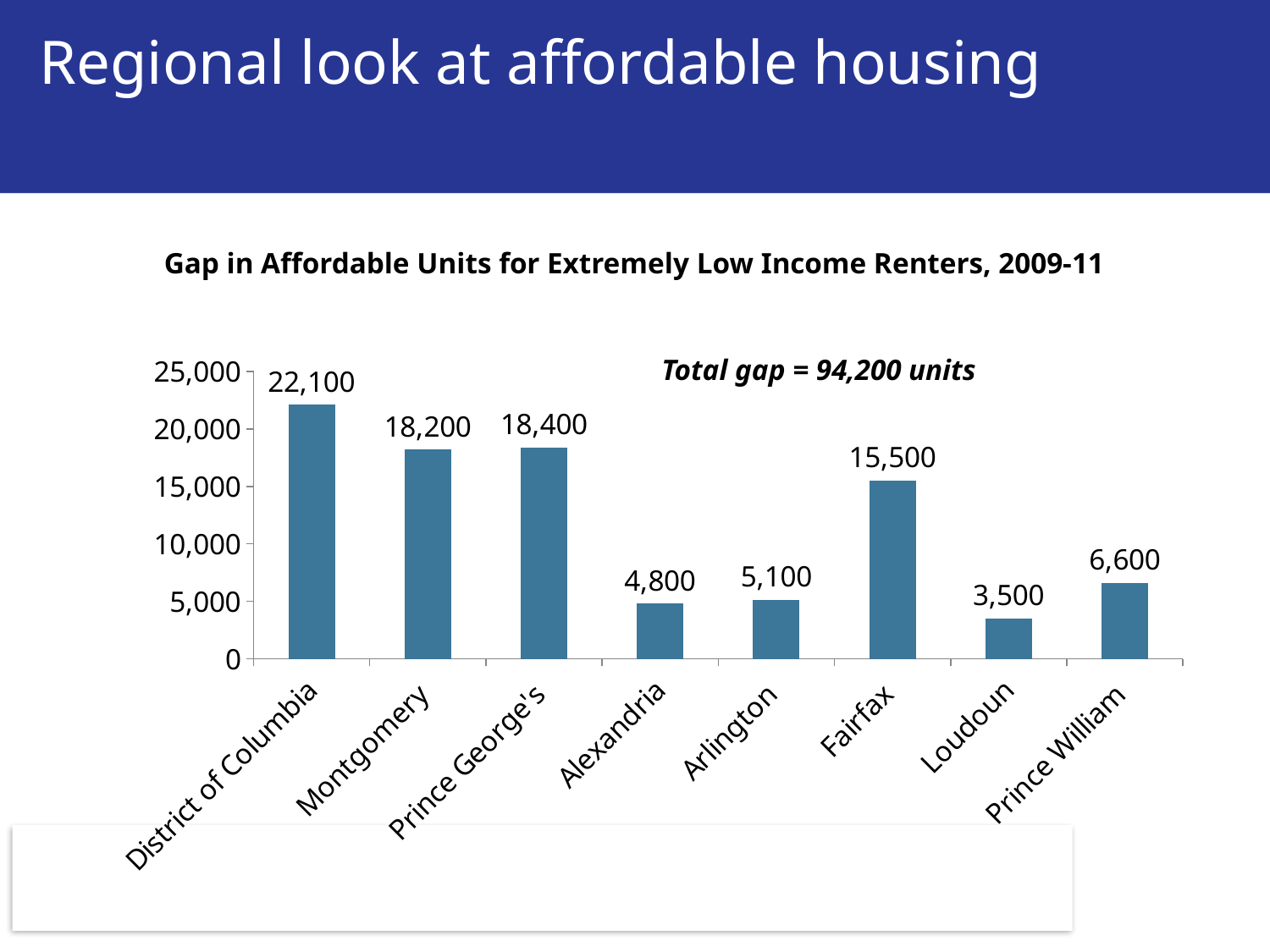
What is the gap in affordable units for Fairfax? 15,500 What is the difference between the gap for Prince William and the gap for Alexandria? 1,800 Which has a larger gap in affordable units, Fairfax or Prince George's? Prince George's What total gap in units does the chart annotation state? 94,200 units What is the gap in affordable units for Loudoun? 3,500 Is the gap for Arlington greater or less than 10,000? less What kind of chart is shown on the slide? bar chart How many jurisdictions are shown in the chart? 8 Which jurisdiction has the largest gap in affordable units? District of Columbia What is the gap in affordable units for the District of Columbia? 22,100 Which jurisdiction has the smallest gap in affordable units? Loudoun What is the difference between the gap for the District of Columbia and the gap for Montgomery? 3,900